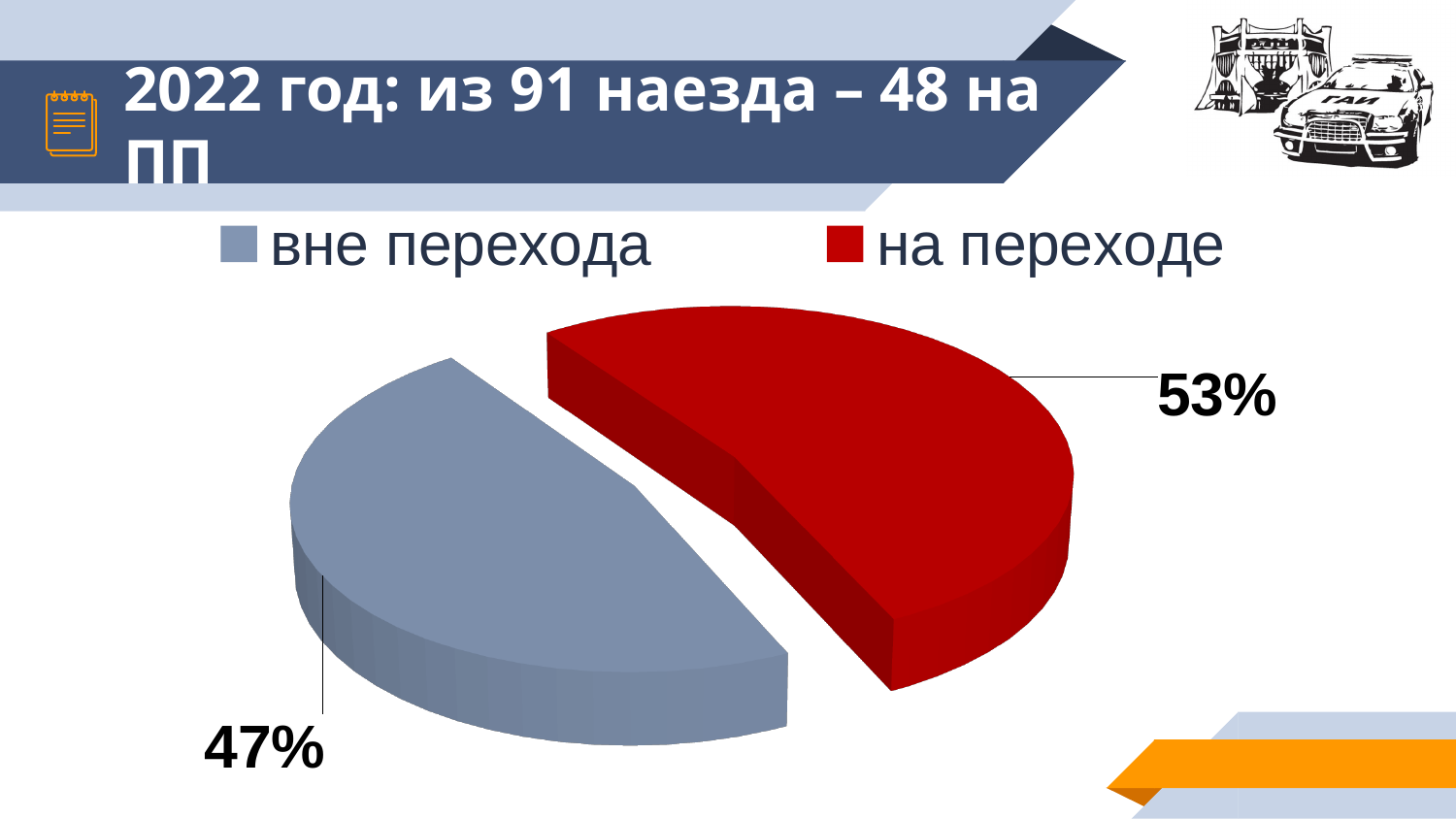
What is the difference in percentage points between "на переходе" and "вне перехода"? 6 How many entries does the legend list? 2 Which slice is the smallest? вне перехода What colour is the "на переходе" slice? red What share of the pie does "вне перехода" represent? 47% What share of the pie does "на переходе" represent? 53% How many slices does the pie chart have? 2 What kind of chart is shown on the slide? pie chart Is the value for "вне перехода" greater or less than 50%? less Which is larger: "вне перехода" or "на переходе"? на переходе Which slice is the largest? на переходе What colour is the "вне перехода" slice? grey-blue